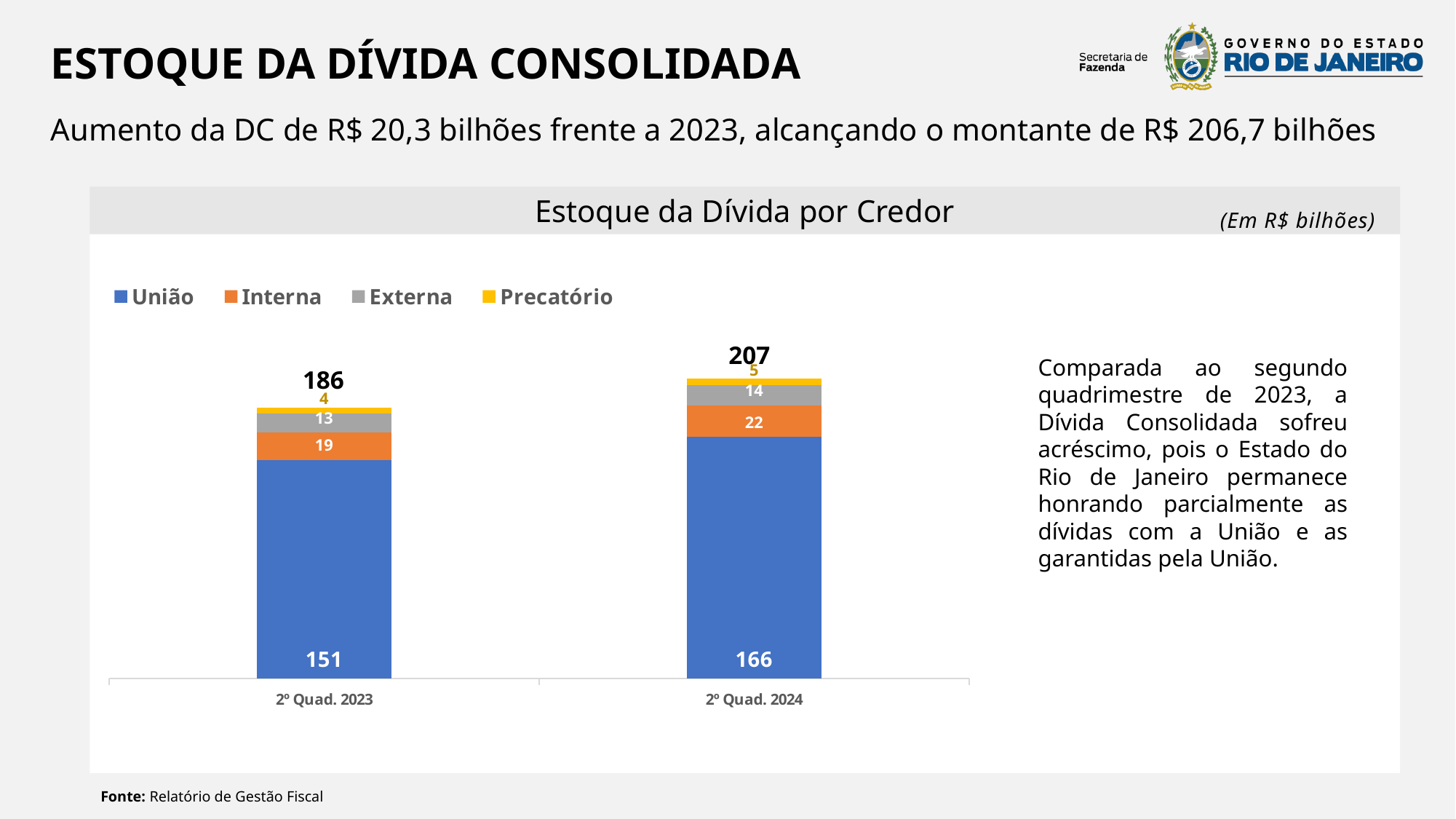
What is the total of the stacked bar for 2º Quad. 2023? 186 How many categories are shown on the x axis? 2 How many series does the legend list? 4 What is the value of Externa for 2º Quad. 2023? 13 What is the value of União for 2º Quad. 2023? 151 What is the difference between the União values for 2º Quad. 2024 and 2º Quad. 2023? 15 Which period has the larger Interna value, 2º Quad. 2023 or 2º Quad. 2024? 2º Quad. 2024 What is the value of Precatório for 2º Quad. 2024? 5 What is the value of Interna for 2º Quad. 2024? 22 Which series has the smallest value in 2º Quad. 2023? Precatório What is the total of the stacked bar for 2º Quad. 2024? 207 What kind of chart is shown? Stacked bar chart